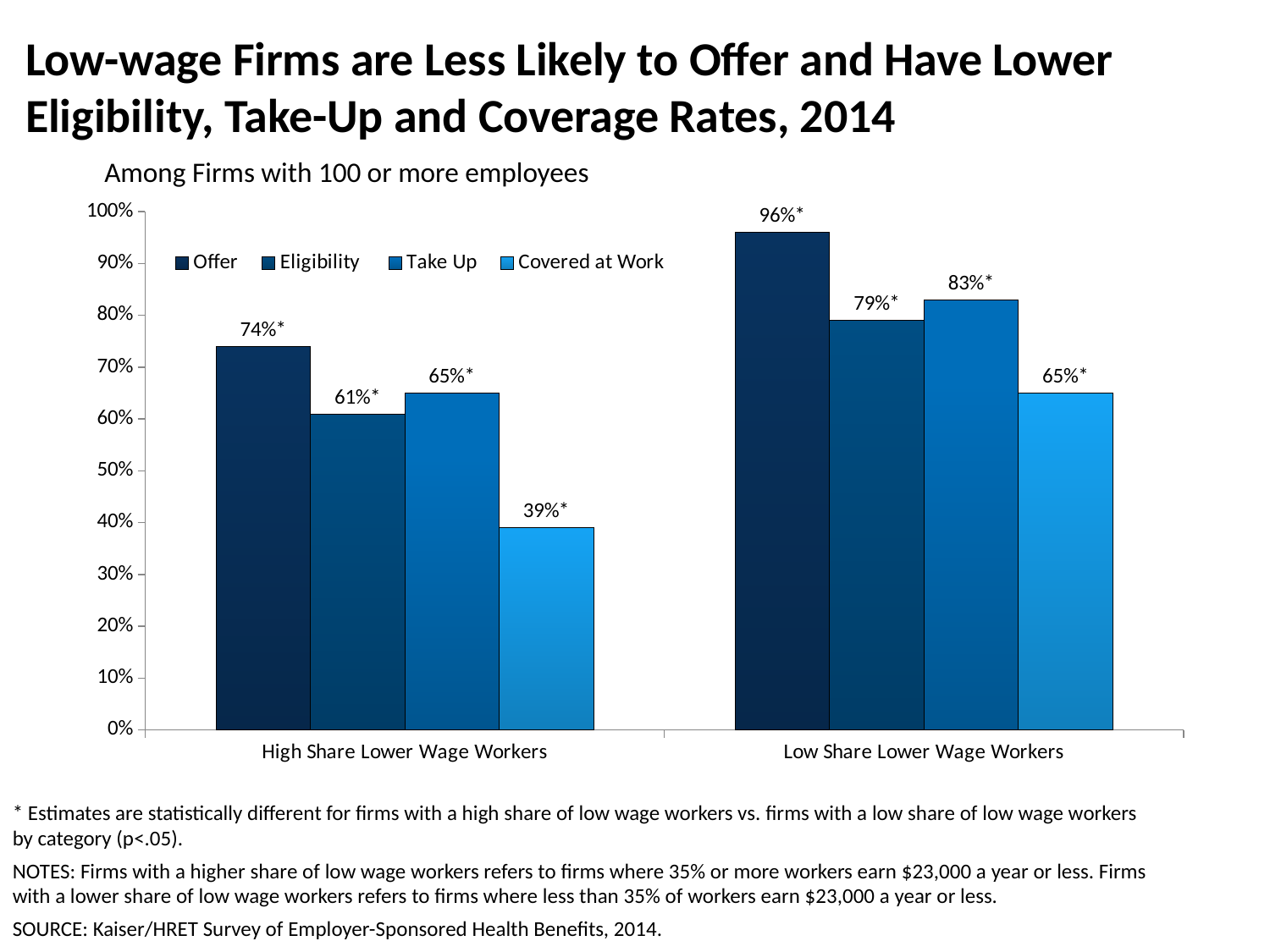
Which series has the lowest value for High Share Lower Wage Workers? Covered at Work How many categories are shown on the x axis? 2 Which is larger: the Take Up value for High Share Lower Wage Workers or the Eligibility value for High Share Lower Wage Workers? Take Up Is the Covered at Work value for High Share Lower Wage Workers greater or less than 40%? less What is the subtitle shown above the chart? Among Firms with 100 or more employees Which series has the highest value for Low Share Lower Wage Workers? Offer What is the Eligibility value for Low Share Lower Wage Workers? 79%* What is the Offer value for High Share Lower Wage Workers? 74%* What is the Covered at Work value for Low Share Lower Wage Workers? 65%* How many series does the legend list? 4 What kind of chart is shown on the slide? Bar chart What is the difference between the Offer values for Low Share Lower Wage Workers and High Share Lower Wage Workers? 22 percentage points